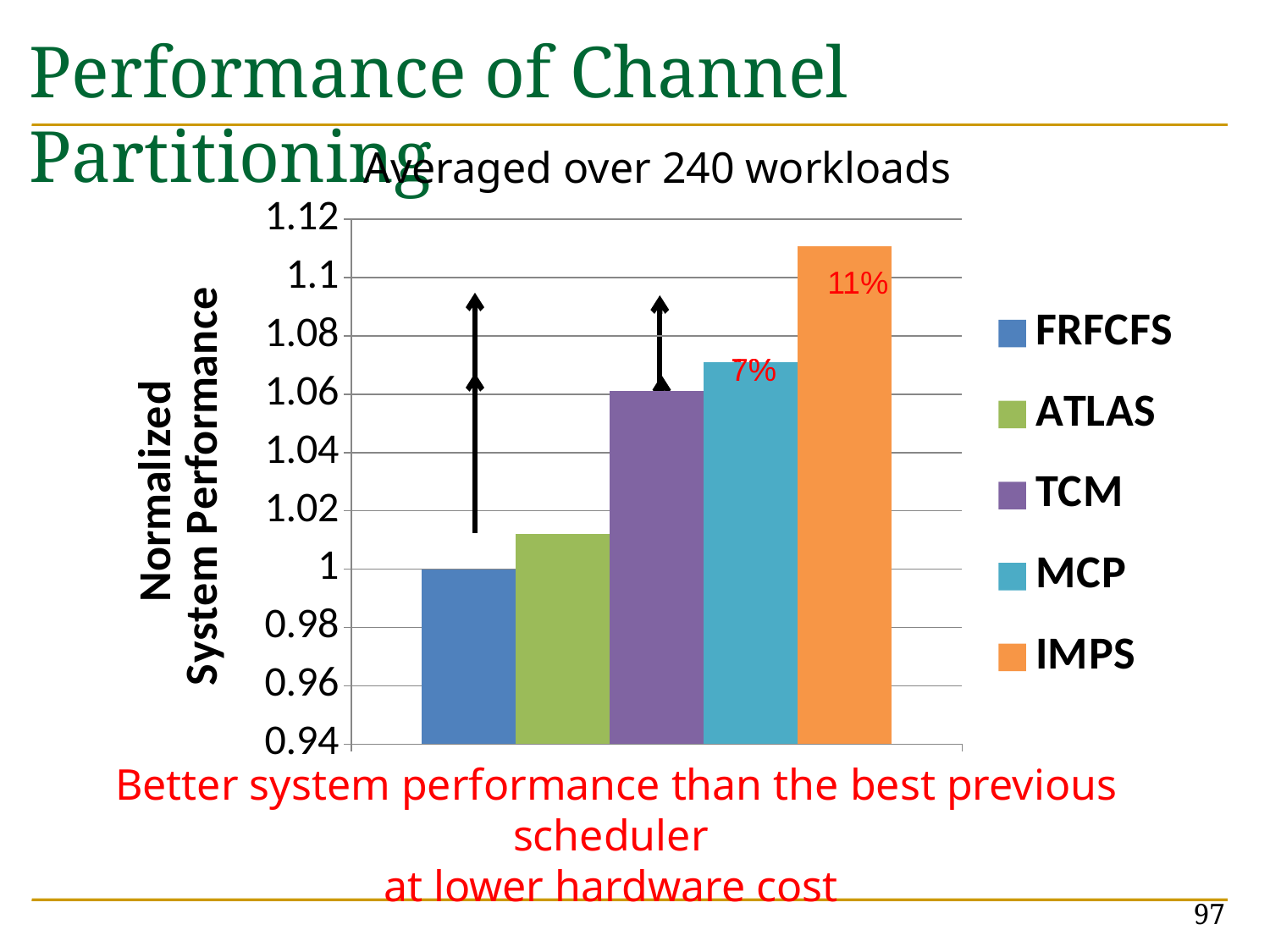
What is the normalized system performance of FRFCFS? 1 Is the value for ATLAS greater or less than 1.02? less Which scheduler has the lowest normalized system performance? FRFCFS Which scheduler has the highest normalized system performance? IMPS How many series does the legend list? 5 Is the value for IMPS greater or less than 1.1? greater What is the label of the vertical axis? Normalized System Performance What is the title of the chart? Averaged over 240 workloads What kind of chart is shown on the slide? bar chart Is the value for MCP greater or less than 1.06? greater Which has a higher normalized system performance, IMPS or MCP? IMPS